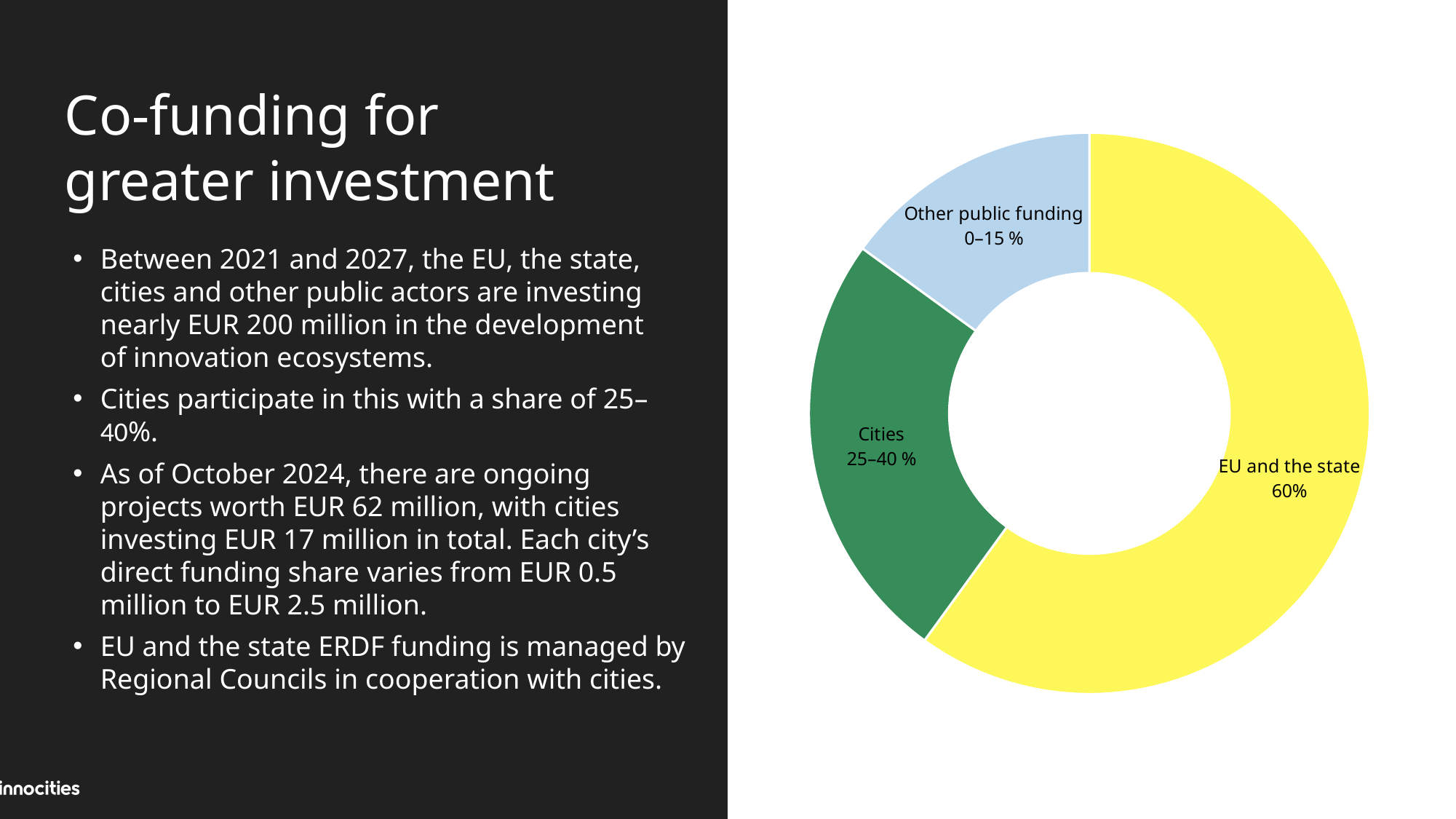
What share of the pie does the EU and the state slice represent? 60% How many categories are shown in the chart? 3 What kind of chart is shown on the slide? Pie (doughnut) chart What share is labelled for EU and the state in the chart? 60% What share is labelled for Other public funding in the chart? 0–15 % Which slice is larger, Cities or Other public funding? Cities What colour is the Cities slice? Green Which slice is larger, EU and the state or Cities? EU and the state What share is labelled for Cities in the chart? 25–40 % What colour is the EU and the state slice? Yellow Which category has the smallest slice in the chart? Other public funding Which category has the largest slice in the chart? EU and the state